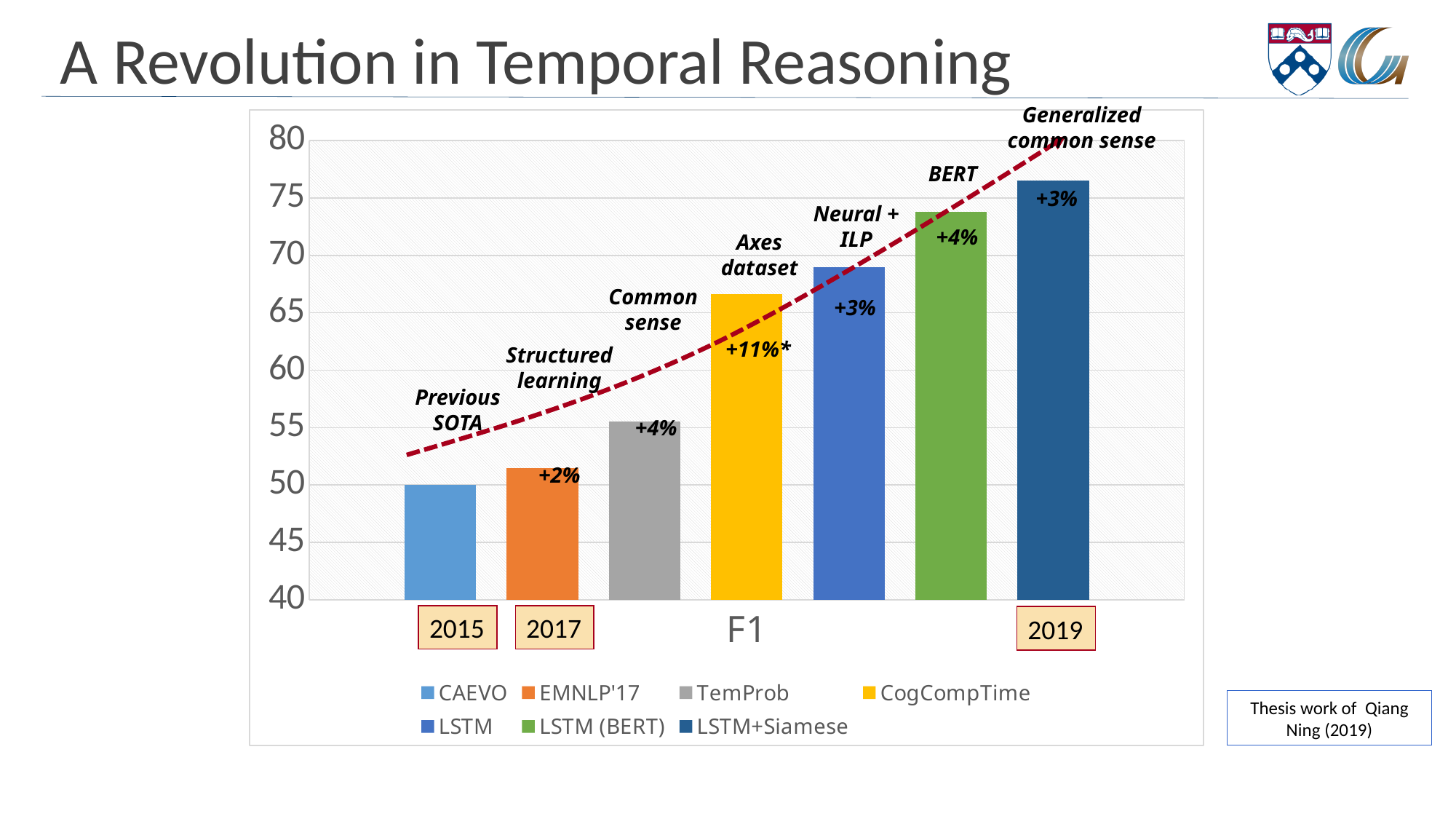
What improvement label is printed on the CogCompTime bar? +11%* What improvement label is printed on the EMNLP'17 bar? +2% Is the F1 value for CogCompTime greater or less than 65? greater What kind of chart is shown on the slide? bar chart What is the F1 value of the CAEVO bar? 50 Is the F1 value for TemProb greater or less than 60? less Which series has the lowest F1 bar? CAEVO How many series does the legend list? 7 Which series has the highest F1 bar? LSTM+Siamese What is the title of the slide containing the chart? A Revolution in Temporal Reasoning Which bar is taller, LSTM (BERT) or LSTM? LSTM (BERT) Is the F1 value for LSTM+Siamese greater or less than 75? greater